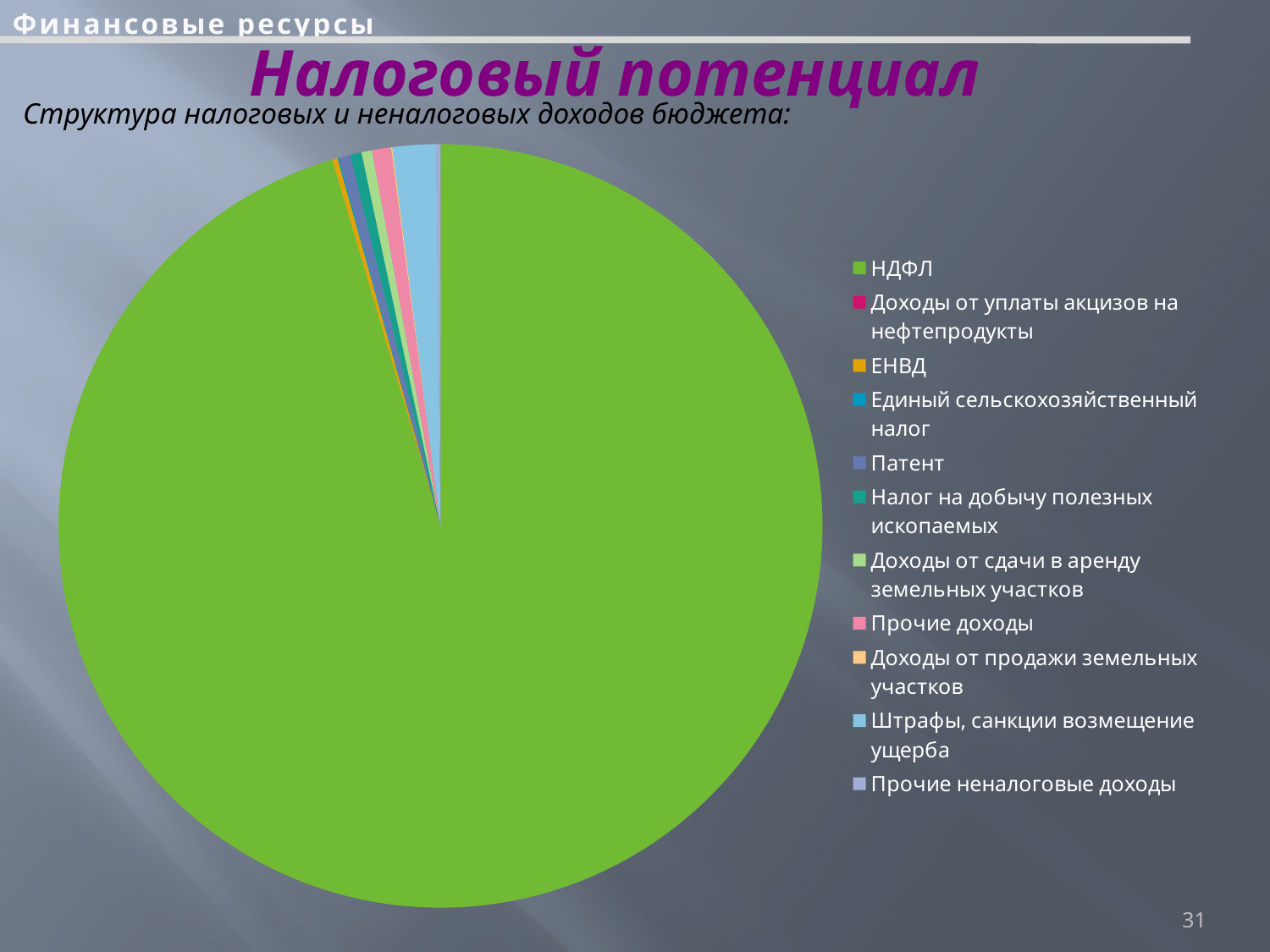
Which slice is larger: ЕНВД or НДФЛ? НДФЛ What kind of chart is shown on the slide? pie chart Which slice is larger: НДФЛ or Прочие доходы? НДФЛ How many categories does the legend of the pie chart list? 11 Which slice is larger: НДФЛ or Штрафы, санкции возмещение ущерба? НДФЛ What is the subtitle written above the pie chart? Структура налоговых и неналоговых доходов бюджета: What colour is the НДФЛ slice in the pie chart? green Which category has the largest slice of the pie? НДФЛ